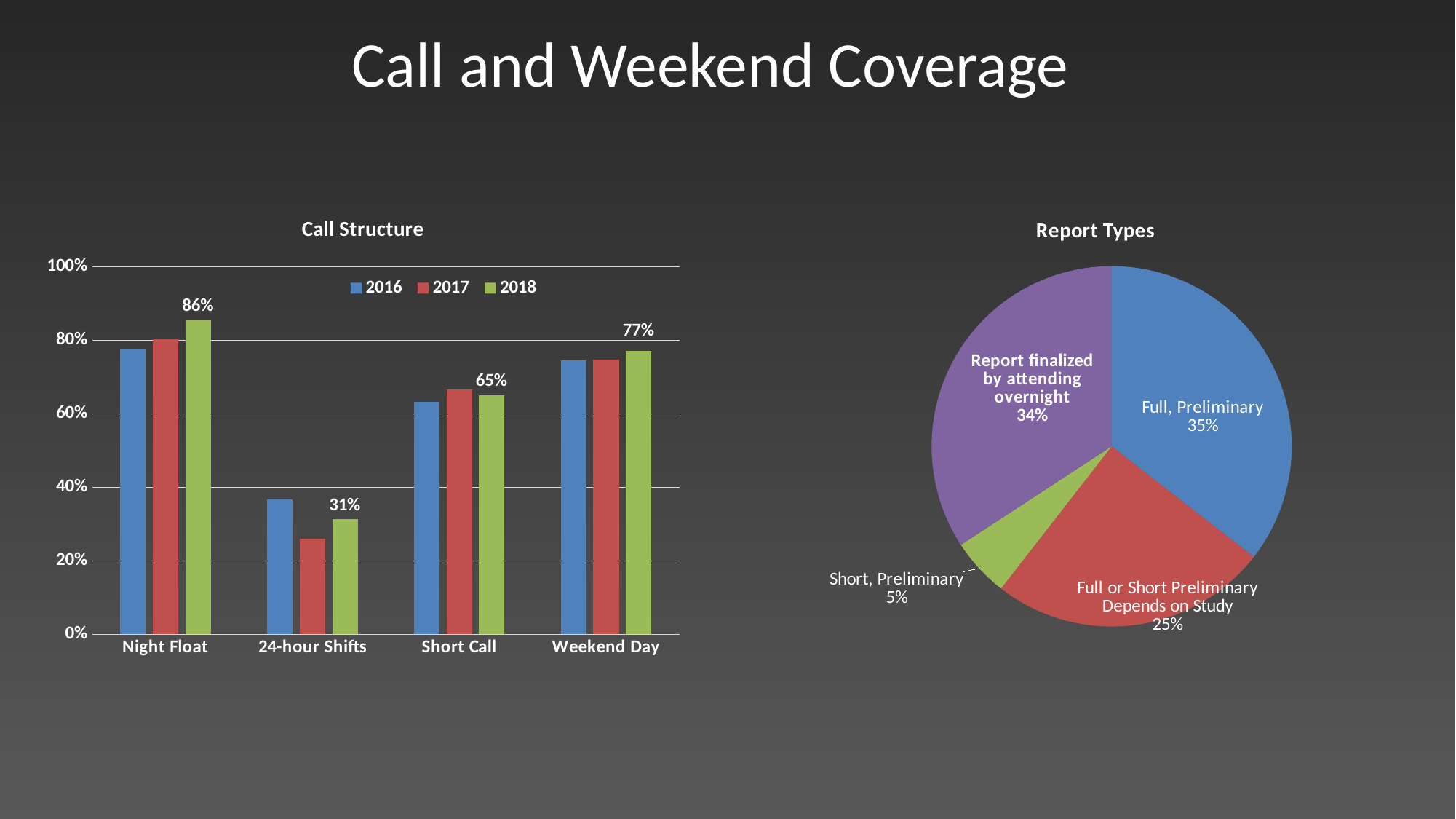
In the Report Types chart, which slice is the smallest? Short, Preliminary In the Report Types chart, what share does Full, Preliminary have? 35% In the Call Structure chart, what is the 2018 value for Weekend Day? 77% In the Call Structure chart, what is the 2018 value for 24-hour Shifts? 31% In the Call Structure chart, is the 2016 value for Night Float greater or less than 60%? greater In the Call Structure chart, which category has the lowest 2018 value? 24-hour Shifts In the Call Structure chart, what is the difference between the 2018 values for Night Float and Short Call? 21% What kind of chart is the Report Types chart? Pie chart How many categories are shown on the x axis of the Call Structure chart? 4 In the Call Structure chart, what is the 2018 value for Night Float? 86% In the Call Structure chart, is the 2017 value for 24-hour Shifts greater or less than 40%? less How many series does the legend of the Call Structure chart list? 3